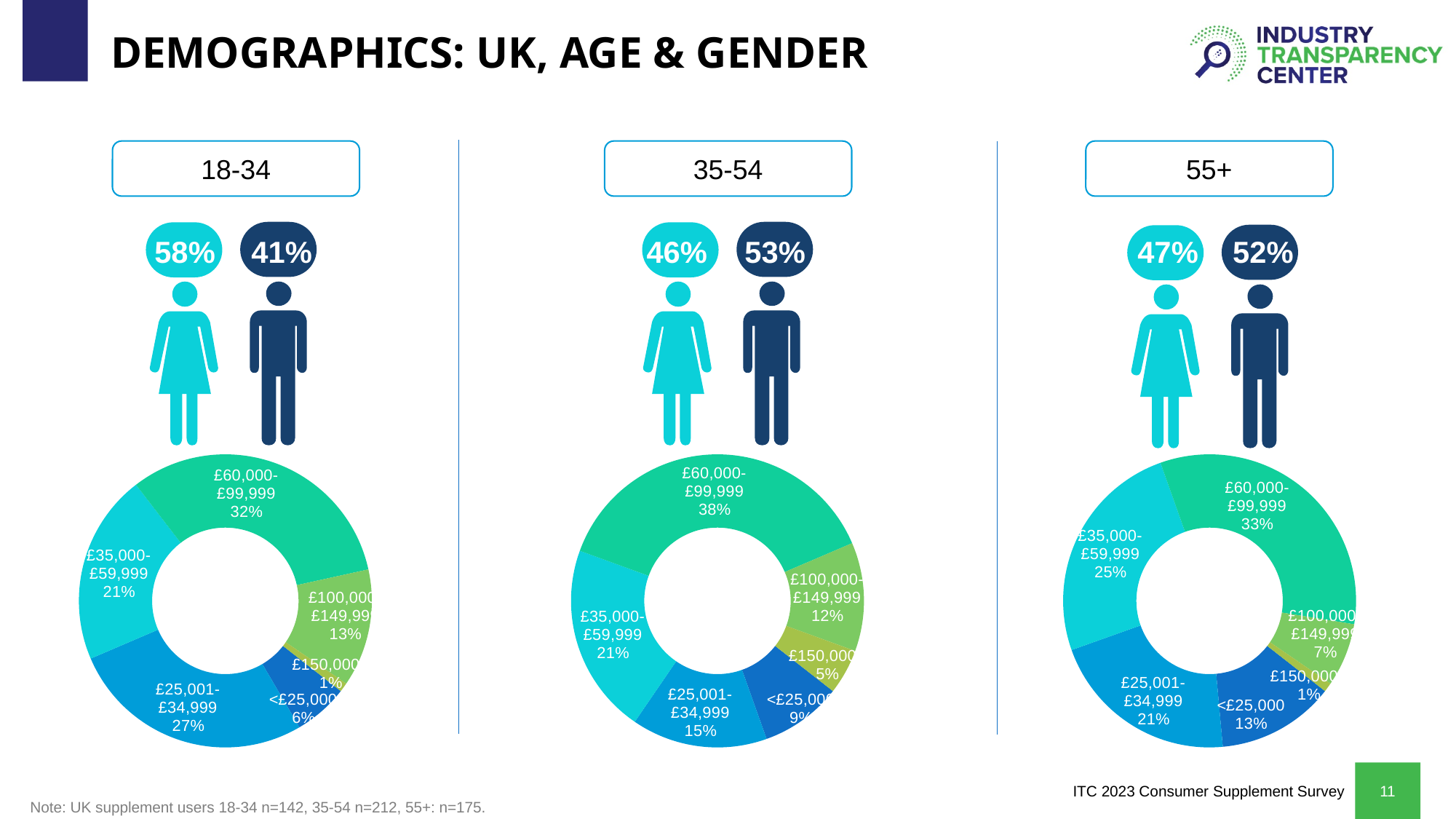
In the 55+ donut chart, which income bracket has the smallest share? £150,000+ What percentage of the 18-34 age group is female according to the slide? 58% What type of chart is used to show income brackets for each age group? Donut chart In the 18-34 donut chart, what share of respondents earn £60,000-£99,999? 32% In the 18-34 donut chart, what is the difference between the £25,001-£34,999 share and the <£25,000 share? 21% In the 55+ donut chart, what share of respondents earn <£25,000? 13% In the 35-54 donut chart, what is the combined share of the £100,000-£149,999 and £150,000+ brackets? 17% In the 55+ donut chart, which is larger: the £35,000-£59,999 share or the £25,001-£34,999 share? £35,000-£59,999 In the 35-54 donut chart, which income bracket has the largest share? £60,000-£99,999 What percentage of the 55+ age group is male according to the slide? 52% How many income brackets are shown in the 35-54 donut chart? 6 In the 35-54 donut chart, what share of respondents earn £25,001-£34,999? 15%